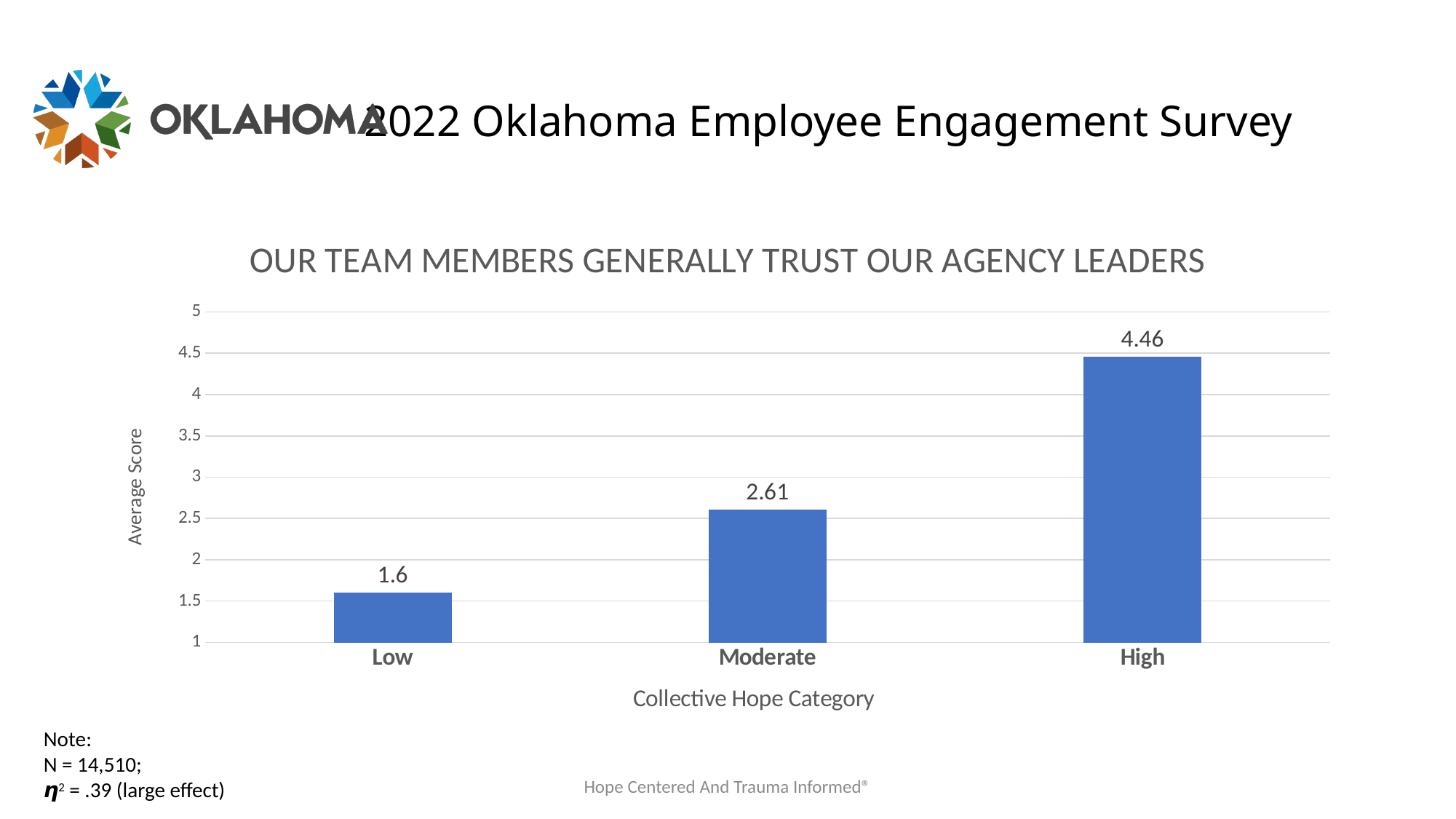
Which collective hope category has the lowest average score? Low What is the average score for the High collective hope category? 4.46 Which has a larger average score, Moderate or High? High What is the average score for the Low collective hope category? 1.6 Do the average scores rise or fall from Low to High along the x axis? Rise What is the difference between the average scores for the Moderate and Low categories? 1.01 What is the average score for the Moderate collective hope category? 2.61 What is the difference between the average scores for the High and Low categories? 2.86 What kind of chart is shown on the slide? Bar chart What is the title of the chart? OUR TEAM MEMBERS GENERALLY TRUST OUR AGENCY LEADERS How many collective hope categories are shown on the chart? 3 Which collective hope category has the highest average score? High